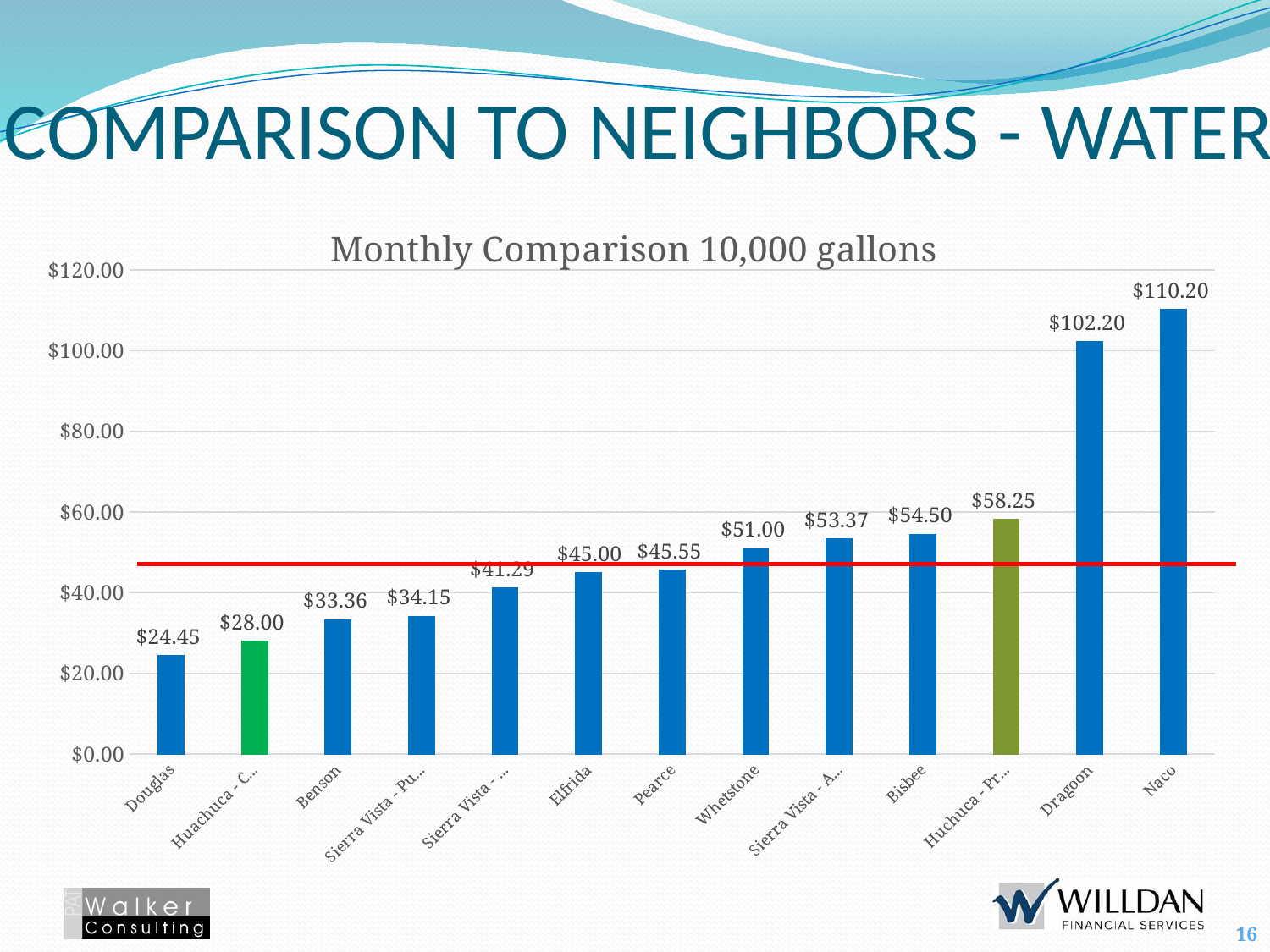
Which category has the lowest value in the chart? Douglas What type of chart is shown on the slide? Bar chart What is the value for Bisbee in the chart? $54.50 Which is larger, the value for Pearce or the value for Elfrida? Pearce Which category has the highest value in the chart? Naco What is the value for Naco in the Monthly Comparison 10,000 gallons chart? $110.20 What is the value for Douglas in the chart? $24.45 Is the value for Dragoon greater or less than $100.00? greater What is the difference between the values for Bisbee and Benson? $21.14 How many categories are shown on the x axis of the chart? 13 What is the value for Whetstone in the chart? $51.00 What is the difference between the values for Naco and Dragoon? $8.00